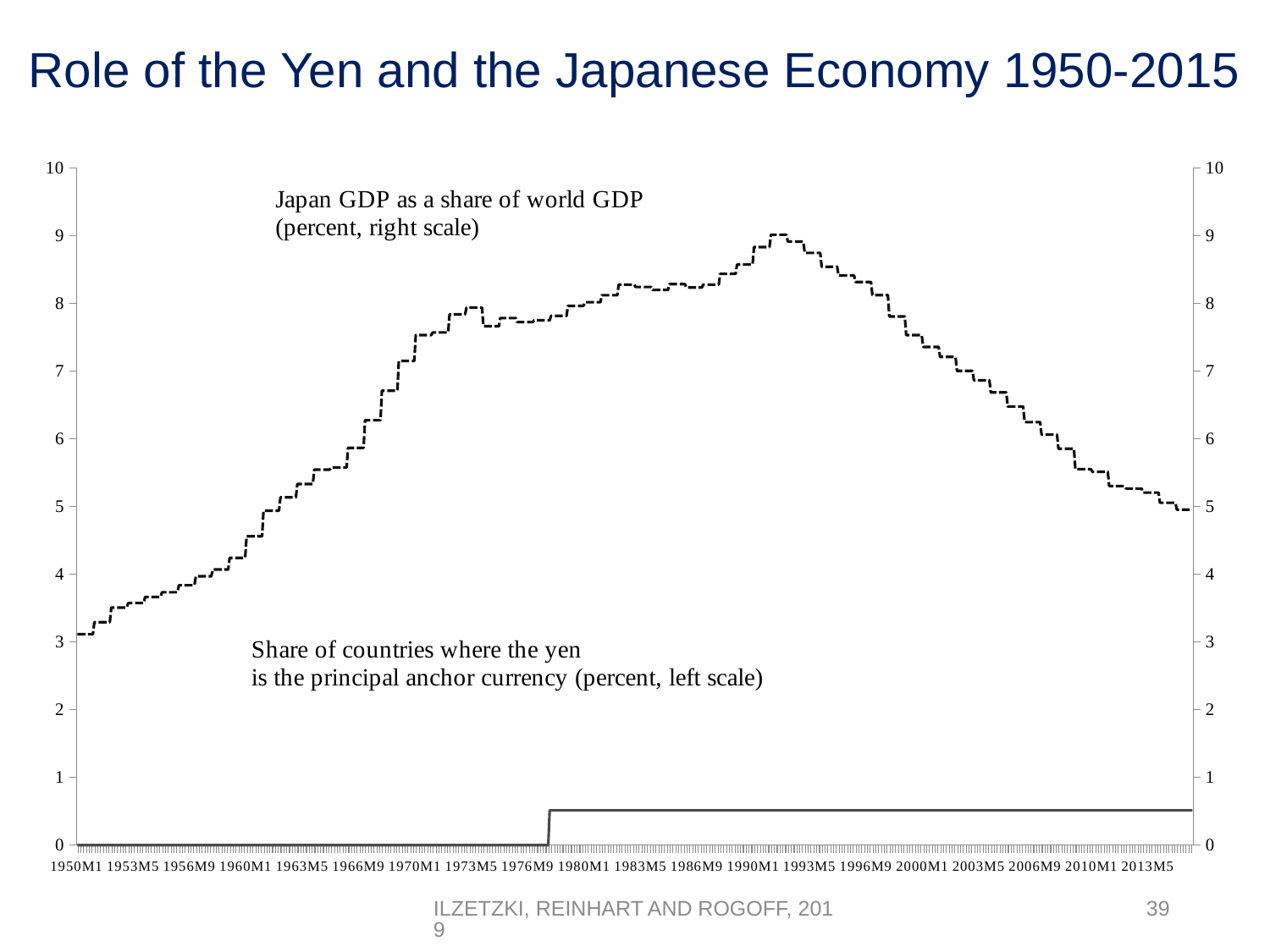
What kind of chart is shown on the slide? line chart What is the title of the slide? Role of the Yen and the Japanese Economy 1950-2015 Is the value of Japan GDP as a share of world GDP at 1950M1 greater or less than 4? less How many series are plotted on the chart? 2 Is the share of countries where the yen is the principal anchor currency higher at 1960M1 or at 1990M1? 1990M1 Is Japan GDP as a share of world GDP higher at 1990M1 or at 2013M5? 1990M1 Which scale does the series 'Japan GDP as a share of world GDP' use, left or right? right scale Does Japan GDP as a share of world GDP rise or fall between 1950M1 and 1970M1? rise Is the value of Japan GDP as a share of world GDP at 2013M5 greater or less than 6? less Is the peak value of Japan GDP as a share of world GDP greater or less than 8? greater Does Japan GDP as a share of world GDP rise or fall between 1993M5 and 2013M5? fall